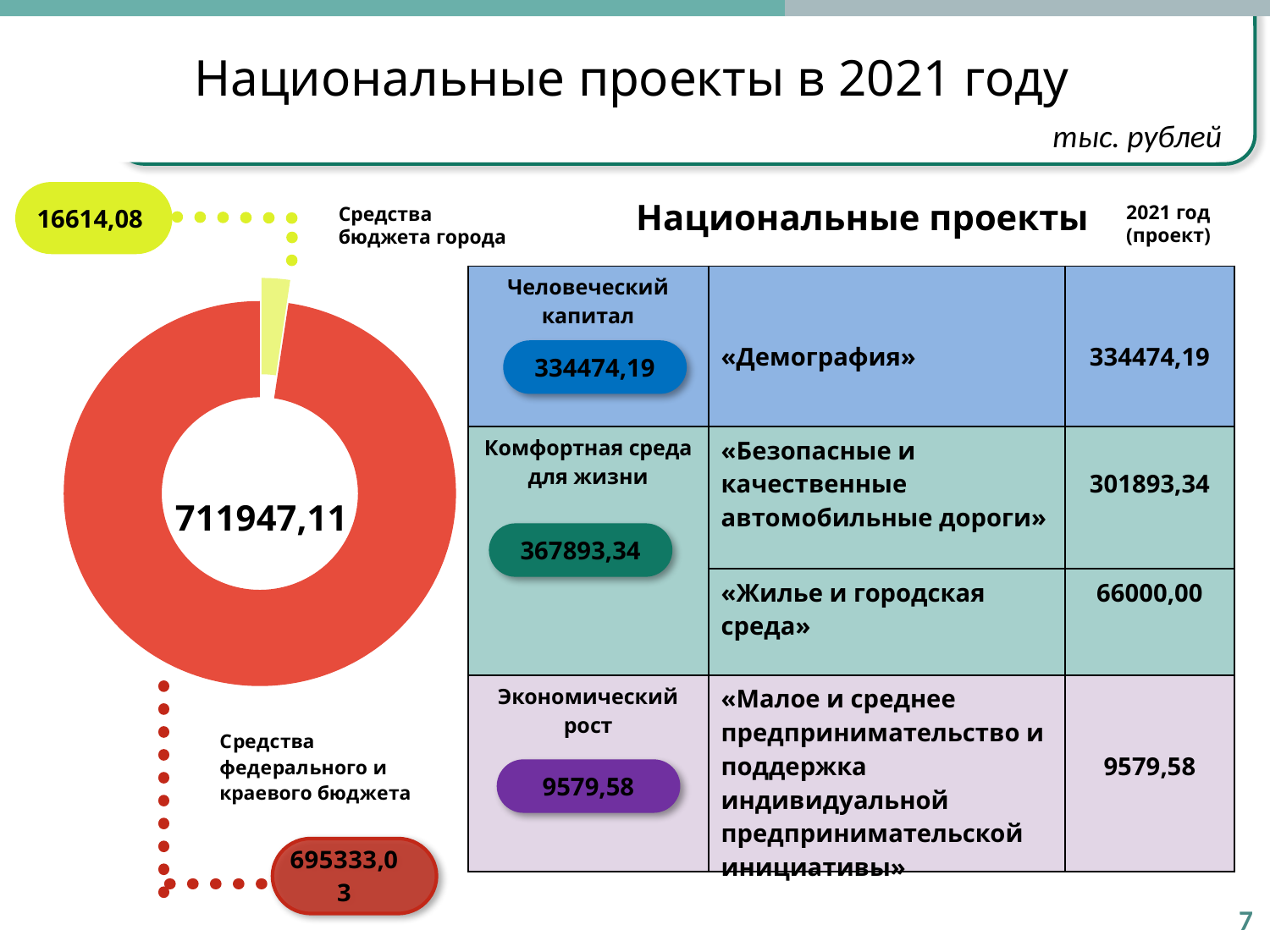
What is the difference between «Средства федерального и краевого бюджета» and «Средства бюджета города» in the doughnut chart? 678718,95 What is the value for «Средства федерального и краевого бюджета» in the doughnut chart? 695333,03 What colour is the «Средства бюджета города» slice in the doughnut chart? Yellow How many slices does the doughnut chart have? 2 What is the value for «Средства бюджета города» in the doughnut chart? 16614,08 In what units are the values on the slide given? тыс. рублей What kind of chart is shown on the left of the slide? Doughnut (pie) chart Which slice of the doughnut chart is the largest? Средства федерального и краевого бюджета What is the sum of the two slices of the doughnut chart? 711947,11 Which is larger in the doughnut chart: «Средства бюджета города» or «Средства федерального и краевого бюджета»? Средства федерального и краевого бюджета Which slice of the doughnut chart is the smallest? Средства бюджета города What total value is printed in the centre of the doughnut chart? 711947,11